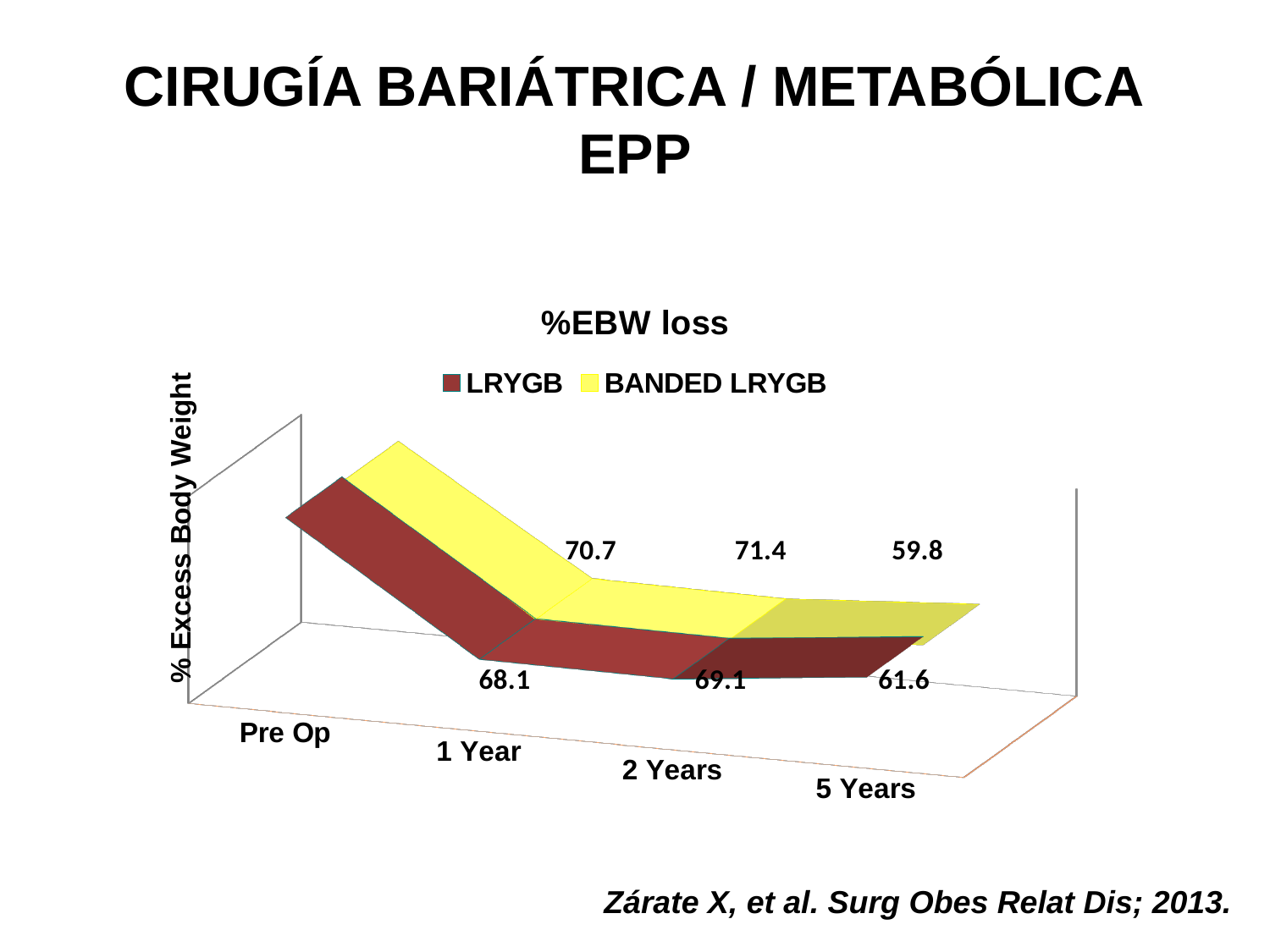
How many time points are shown on the x axis? 4 At 2 Years, which series has the higher value, LRYGB or BANDED LRYGB? BANDED LRYGB What is the difference between the BANDED LRYGB and LRYGB values at 1 Year? 2.6 What is the title of the chart? %EBW loss What is the value for BANDED LRYGB at 2 Years? 71.4 How many series does the legend list? 2 What is the value for LRYGB at 5 Years? 61.6 By how much does the LRYGB value drop from 2 Years to 5 Years? 7.5 Among the labeled time points, at which one does BANDED LRYGB reach its highest value? 2 Years What is the value for BANDED LRYGB at 5 Years? 59.8 What is the value for LRYGB at 1 Year? 68.1 At 5 Years, which series has the higher value, LRYGB or BANDED LRYGB? LRYGB